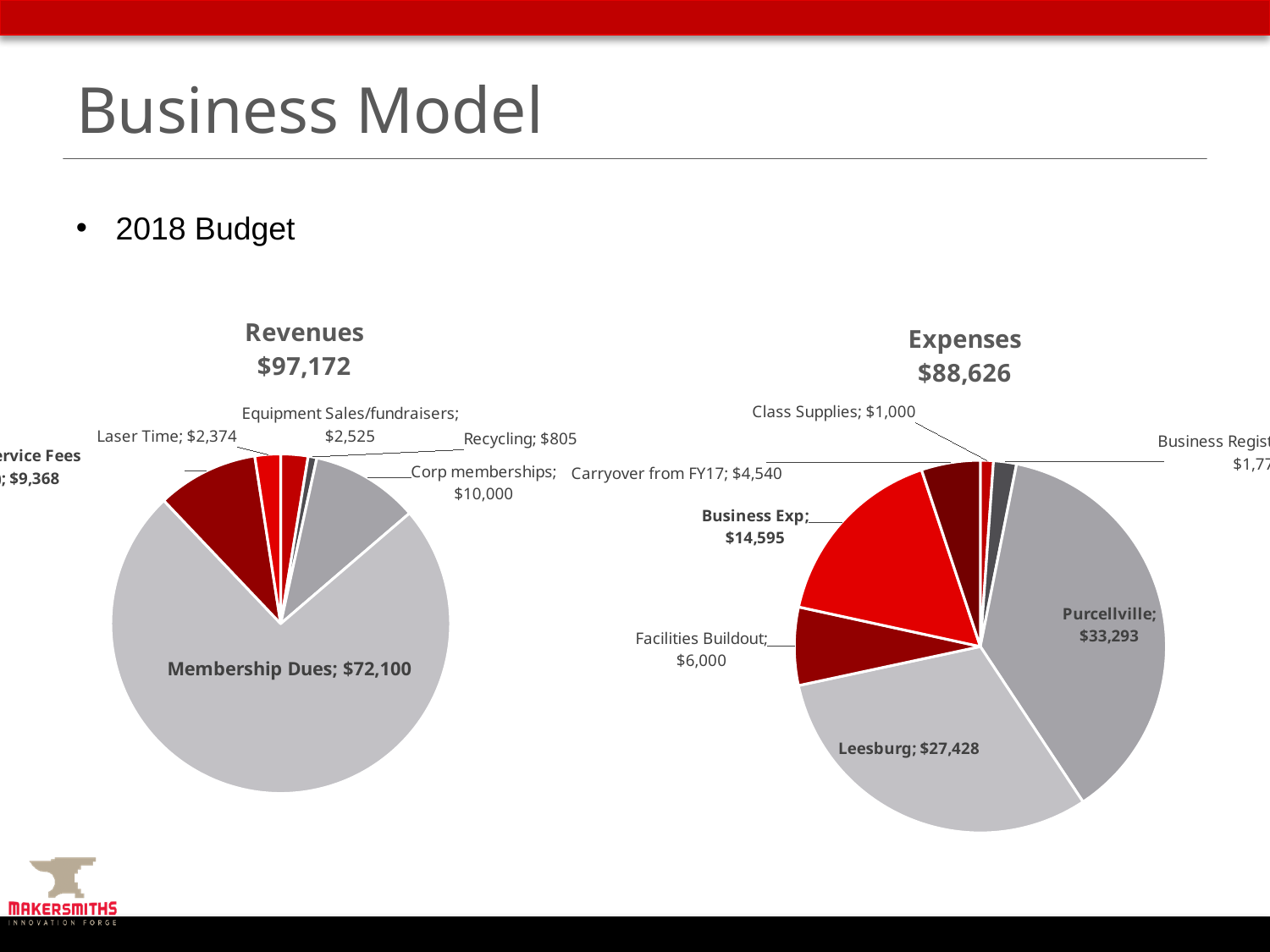
In the Revenues chart, what is the value for Membership Dues? $72,100 In the Expenses chart, what is the value for Business Exp? $14,595 In the Expenses chart, what is the value for Purcellville? $33,293 What total is shown in the title of the Expenses chart? $88,626 What kind of chart is the Revenues chart? Pie chart In the Expenses chart, which category has the largest slice? Purcellville In the Expenses chart, what is the difference between Purcellville and Leesburg? $5,865 In the Revenues chart, what is the difference between Corp memberships and Laser Time? $7,626 In the Revenues chart, what is the value for Recycling? $805 In the Revenues chart, which category has the largest slice? Membership Dues In the Revenues chart, what is the value for Corp memberships? $10,000 In the Revenues chart, which is larger: Equipment Sales/fundraisers or Laser Time? Equipment Sales/fundraisers